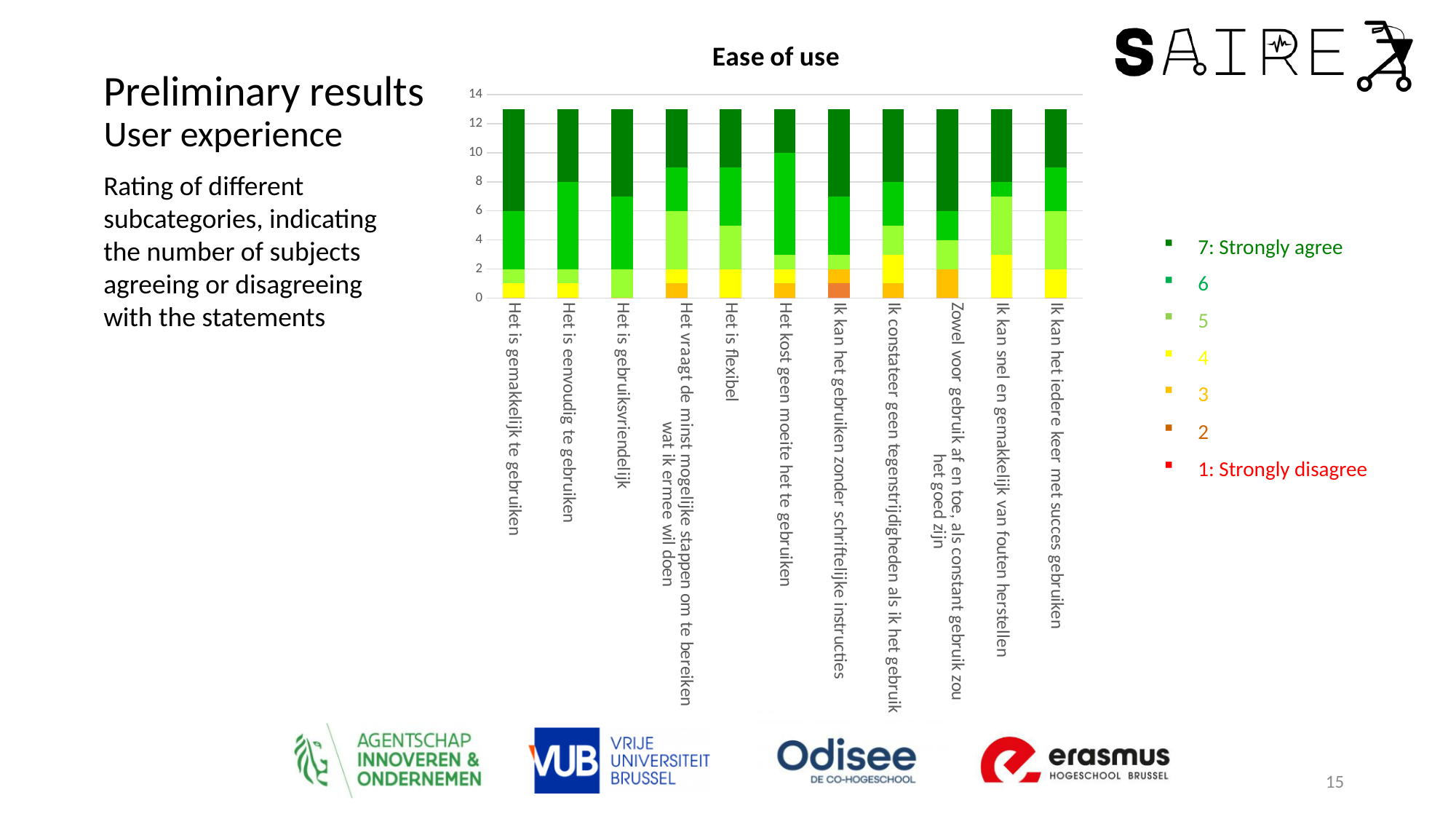
How many categories (statements) are plotted along the x axis of the chart? 11 Which statement has the largest '4' (yellow) segment? Ik kan snel en gemakkelijk van fouten herstellen Which statement is the only one with a rating '2' segment? Ik kan het gebruiken zonder schriftelijke instructies Which statement has the smallest '7: Strongly agree' segment? Het kost geen moeite het te gebruiken Is the total height of the bar for 'Het is flexibel' greater or less than 12? greater What is the title of the chart? Ease of use What is the highest value shown on the y axis of the chart? 14 What kind of chart is shown on the slide? Stacked bar chart How many series does the legend of the chart list? 7 Is the total height of the bar for 'Het is eenvoudig te gebruiken' greater or less than 14? less How many bars contain a segment for rating '2'? 1 Which rating does the legend label as 'Strongly agree'? 7